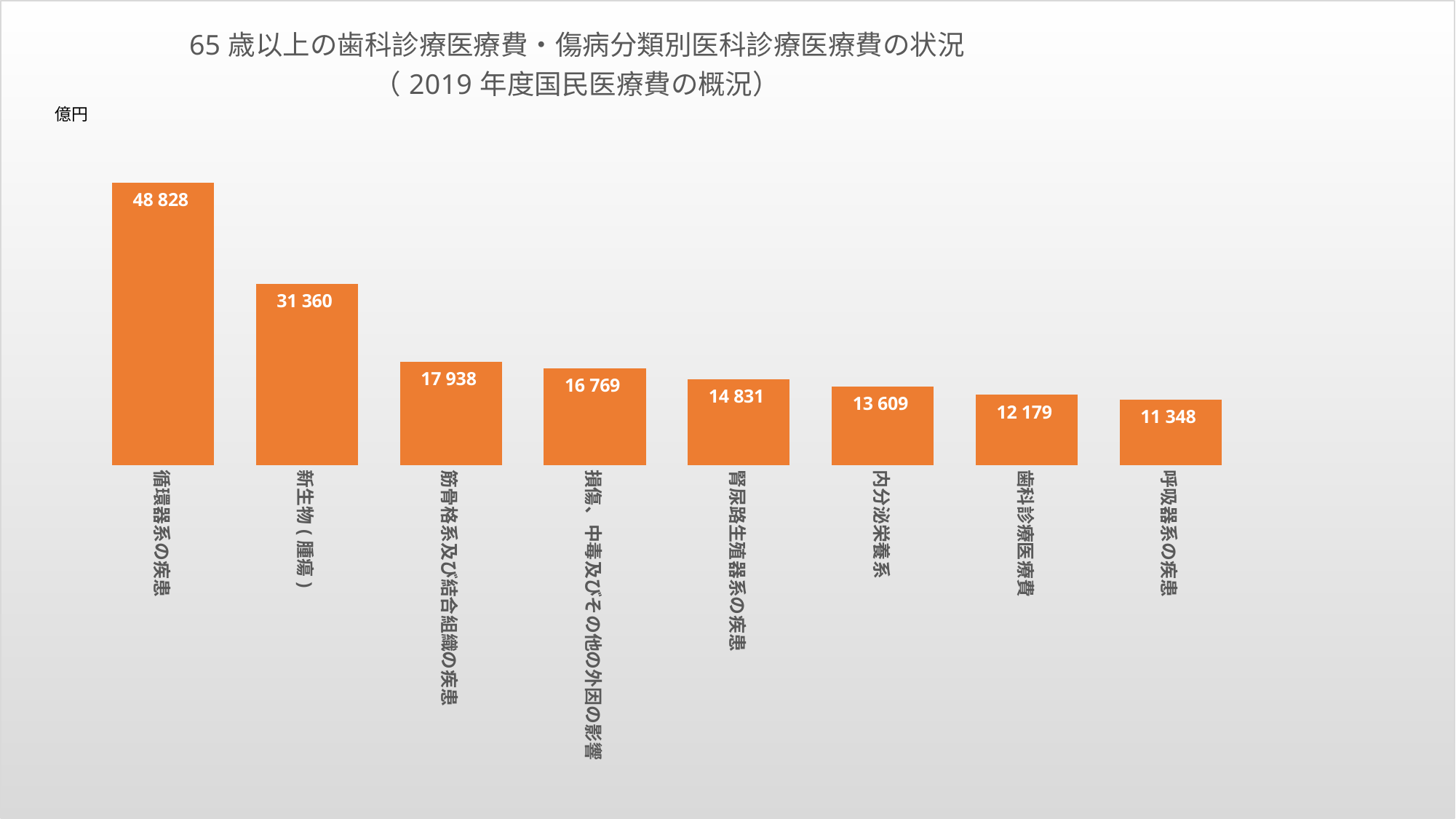
Which category has the lowest value? 呼吸器系の疾患 What is the difference between the values for 歯科診療医療費 and 呼吸器系の疾患? 831 How many categories are shown in the chart? 8 What is the value for 新生物（腫瘍）? 31 360 What unit is indicated at the top left of the chart? 億円 Which category has the highest value? 循環器系の疾患 What is the value for 循環器系の疾患? 48 828 What is the value for 腎尿路生殖器系の疾患? 14 831 What kind of chart is shown on the slide? bar chart Which is larger, the value for 筋骨格系及び結合組織の疾患 or the value for 内分泌栄養系? 筋骨格系及び結合組織の疾患 What is the value for 歯科診療医療費? 12 179 What is the difference between the values for 循環器系の疾患 and 新生物（腫瘍）? 17 468